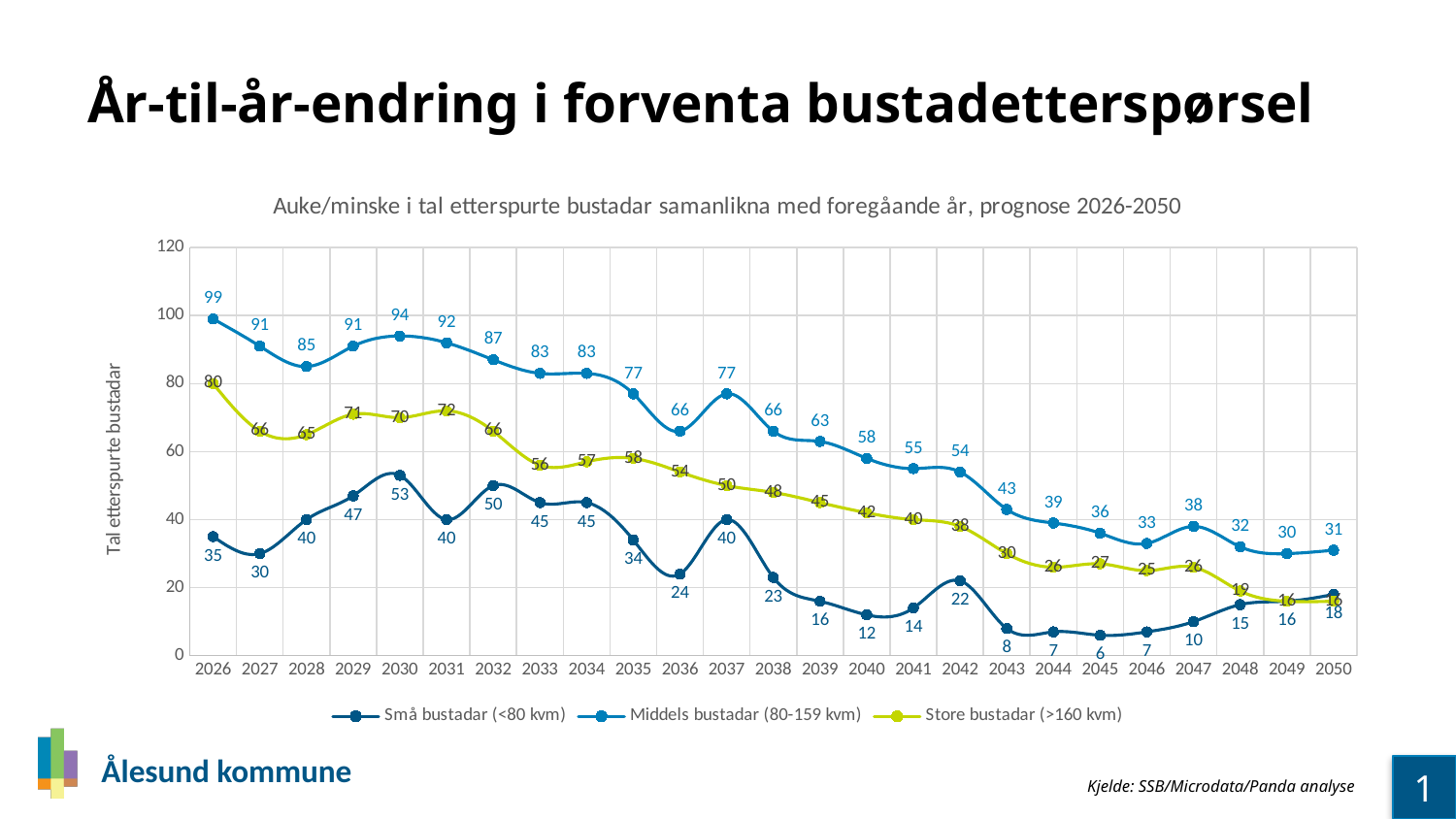
In which year does Middels bustadar (80-159 kvm) reach its highest value? 2026 What is the value for Små bustadar (<80 kvm) in 2030? 53 Does the value for Middels bustadar (80-159 kvm) generally rise or fall from 2026 to 2050? Fall Which series has the higher value in 2050: Små bustadar (<80 kvm) or Store bustadar (>160 kvm)? Små bustadar (<80 kvm) How many years are plotted on the x axis? 25 What is the value for Middels bustadar (80-159 kvm) in 2026? 99 What is the title of the chart? Auke/minske i tal etterspurte bustadar samanlikna med foregåande år, prognose 2026-2050 How many series does the legend list? 3 What is the difference between Middels bustadar (80-159 kvm) and Små bustadar (<80 kvm) in 2026? 64 What is the value for Store bustadar (>160 kvm) in 2037? 50 What kind of chart is shown on the slide? Line chart In which year does Små bustadar (<80 kvm) reach its lowest value? 2045